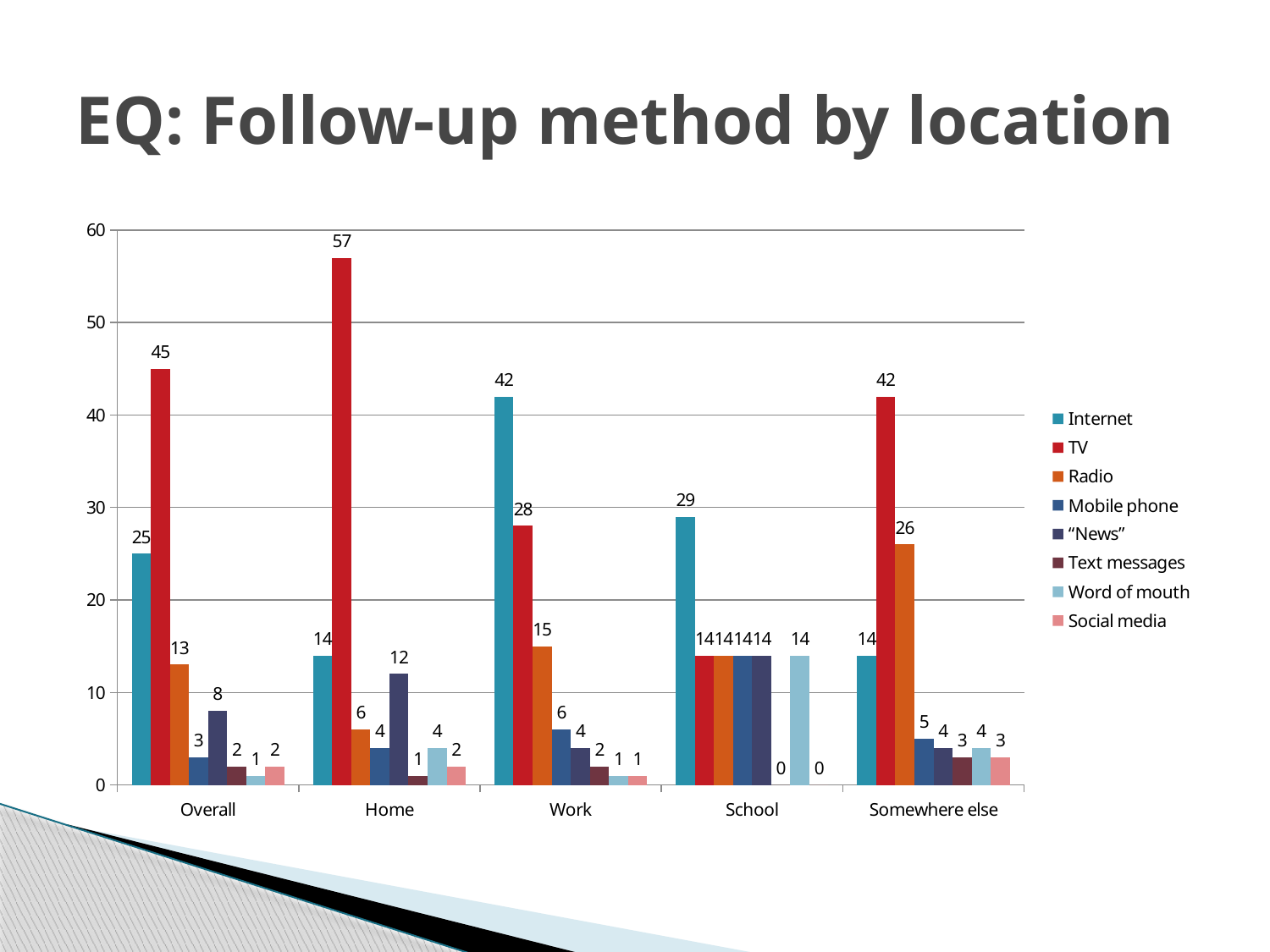
What is the value for TV at Home? 57 What is the value for Radio at Somewhere else? 26 Which location has the lowest Internet value? Home and Somewhere else (both 14) How many series does the legend list? 8 How many location categories are shown on the x axis? 5 What is the value for Internet at Work? 42 What kind of chart is shown on the slide? Bar chart What is the value for "News" at Home? 12 What is the difference between the TV value and the Internet value for Overall? 20 Which location has the highest TV value? Home What is the title of the chart on the slide? EQ: Follow-up method by location At Work, which is larger, Internet or TV? Internet